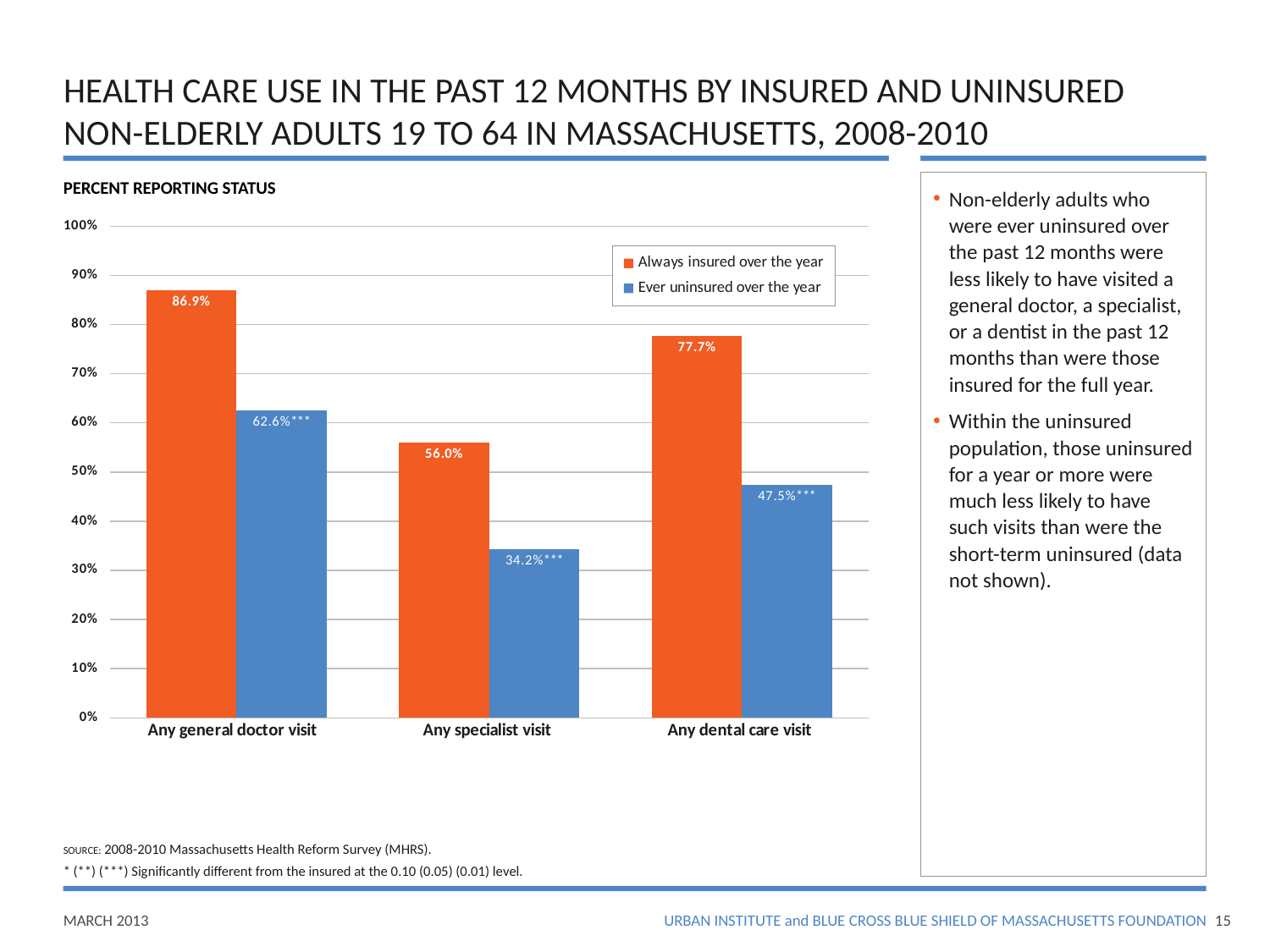
How many series does the legend list? 2 What is the value for 'Ever uninsured over the year' for any dental care visit? 47.5% What kind of chart is shown on the slide? Bar chart What is the difference between the always insured and ever uninsured values for any dental care visit? 30.2 percentage points Which is larger: the always insured value for any specialist visit or the ever uninsured value for any general doctor visit? Ever uninsured value for any general doctor visit What percentage of adults always insured over the year reported any general doctor visit? 86.9% What percentage of adults ever uninsured over the year reported any specialist visit? 34.2% Which colour represents 'Ever uninsured over the year' in the chart? Blue Which category has the lowest value for 'Ever uninsured over the year'? Any specialist visit What is the difference between the always insured and ever uninsured values for any general doctor visit? 24.3 percentage points How many categories are shown on the x axis? 3 Which category has the highest value for 'Always insured over the year'? Any general doctor visit